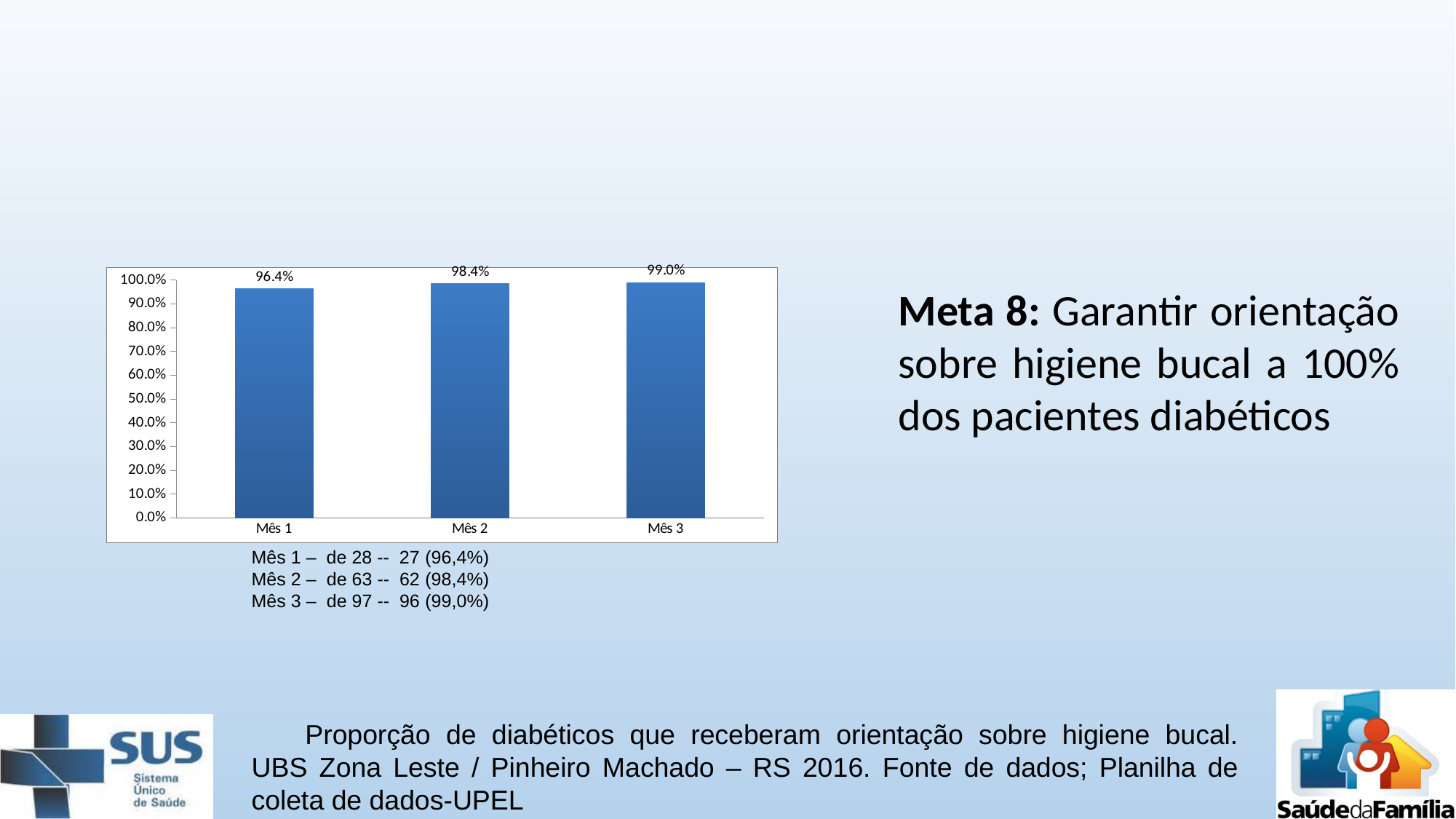
What is the value for Mês 3? 99.0% What is the difference between the values for Mês 2 and Mês 1? 2.0 percentage points What is the value for Mês 1? 96.4% What is the value for Mês 2? 98.4% Which is larger, the value for Mês 1 or the value for Mês 2? Mês 2 Which month has the highest value? Mês 3 What kind of chart is shown on the slide? bar chart What is the difference between the values for Mês 3 and Mês 1? 2.6 percentage points How many months are shown on the x axis? 3 Which month has the lowest value? Mês 1 Is the value for Mês 1 greater or less than 90.0%? greater Do the values rise or fall from Mês 1 to Mês 3? rise